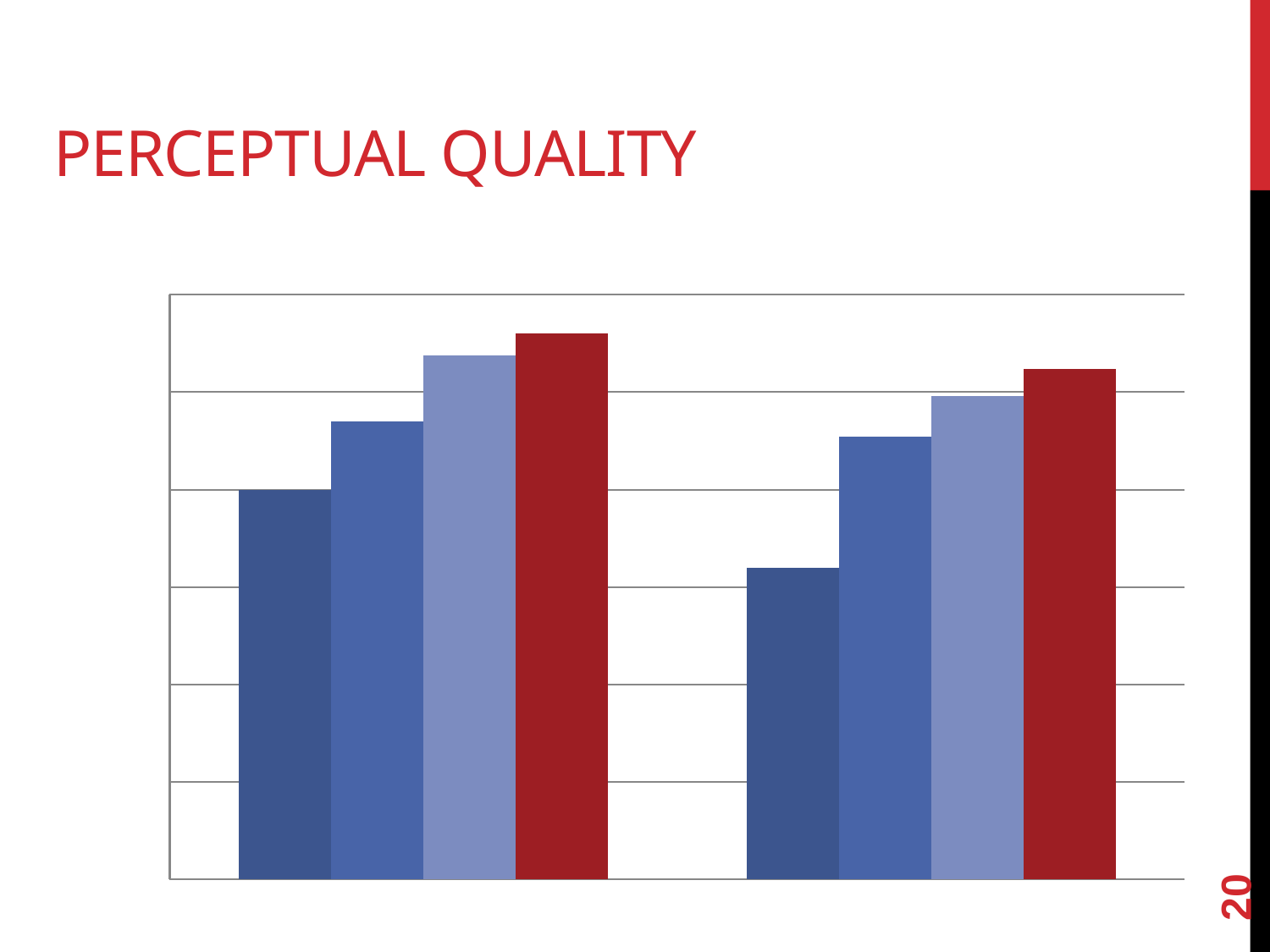
Within each group, do the bars rise or fall from left to right? rise How many bars are plotted in total on the chart? 8 Which is taller: the red bar in the left group or the red bar in the right group? the red bar in the left group How many groups of bars does the chart contain? 2 How many bars are in each group of the chart? 4 What kind of chart is shown on the slide? bar chart In the right group of bars, which bar is the shortest? the dark blue bar In the left group of bars, which bar is the tallest? the red bar In the right group of bars, which bar is the tallest? the red bar What colour is the rightmost bar in each group? red In the left group of bars, which bar is the shortest? the dark blue bar Which is taller: the dark blue bar in the left group or the dark blue bar in the right group? the dark blue bar in the left group